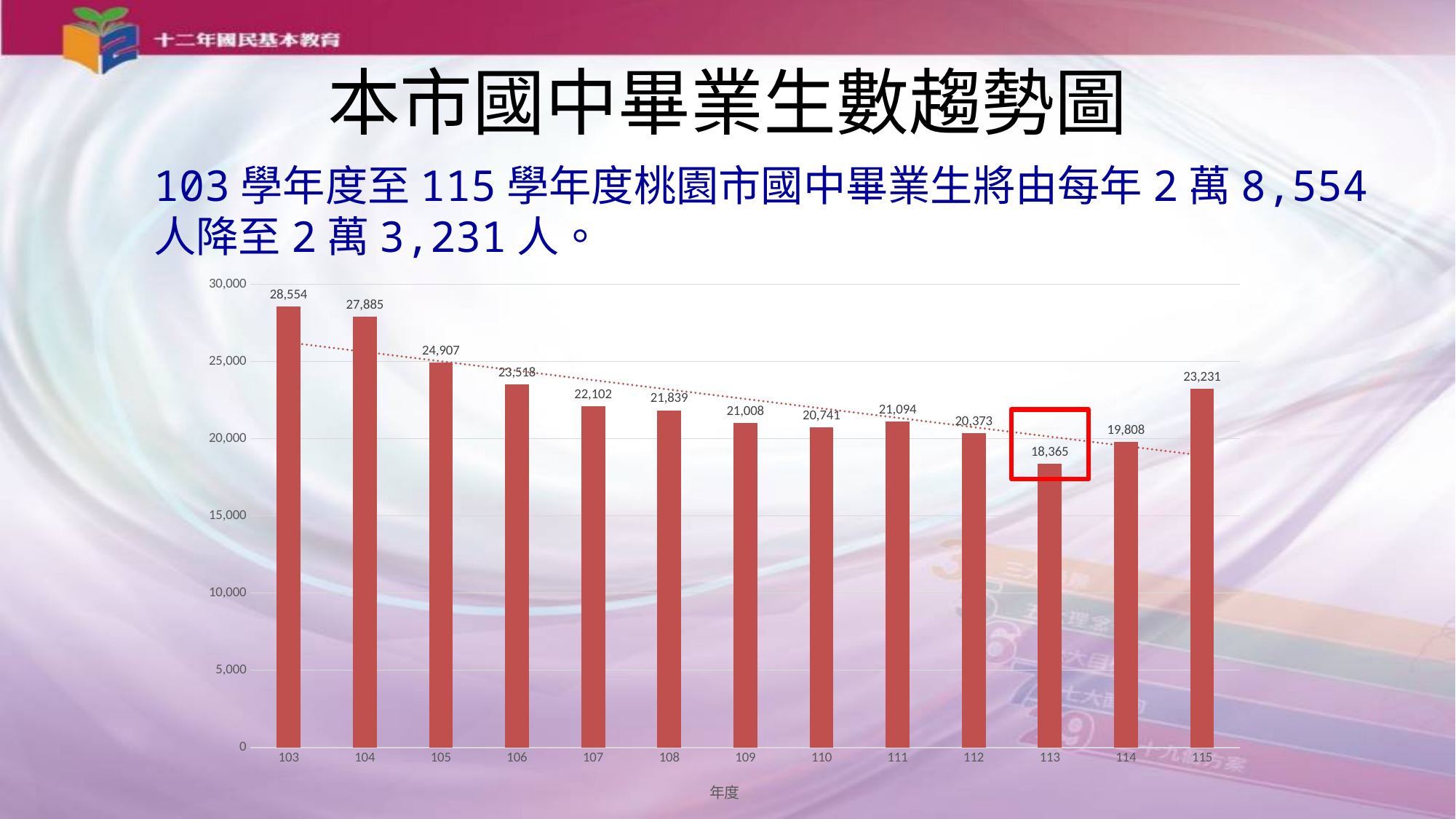
What kind of chart is shown on the slide? bar chart What is the value for year 115? 23,231 Which is larger, the value for year 110 or the value for year 111? 111 What is the label of the x axis? 年度 What is the difference between the values for year 103 and year 115? 5,323 Which year has the highest value? 103 What is the value for year 109? 21,008 How many years are shown on the x axis? 13 Is the value for year 114 greater or less than 20,000? less Which year has the lowest value? 113 What is the value for year 103? 28,554 What is the value for year 113? 18,365